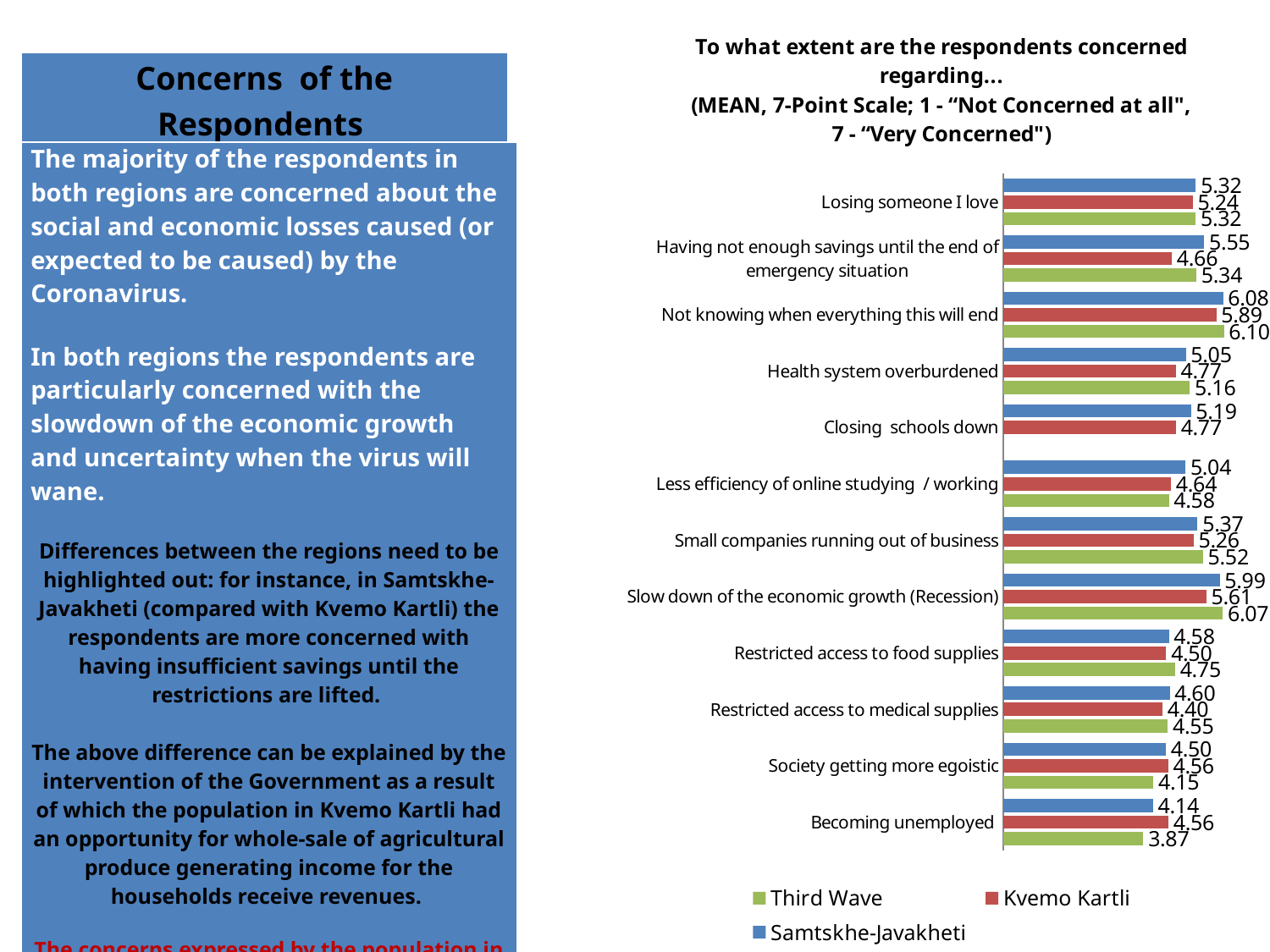
Which series is shown in green in the legend? Third Wave Which category has the highest Samtskhe-Javakheti value? Not knowing when everything this will end How many series does the legend list? 3 What is the Kvemo Kartli value for "Having not enough savings until the end of emergency situation"? 4.66 What is the Kvemo Kartli value for "Closing schools down"? 4.77 How many categories are shown on the chart? 12 What is the Samtskhe-Javakheti value for "Slow down of the economic growth (Recession)"? 5.99 What is the difference between the Samtskhe-Javakheti and Kvemo Kartli values for "Having not enough savings until the end of emergency situation"? 0.89 What kind of chart is shown on the slide? Bar chart For "Becoming unemployed", which is larger: the Kvemo Kartli value or the Samtskhe-Javakheti value? Kvemo Kartli What is the Third Wave value for "Becoming unemployed"? 3.87 Which category has the lowest Third Wave value? Becoming unemployed